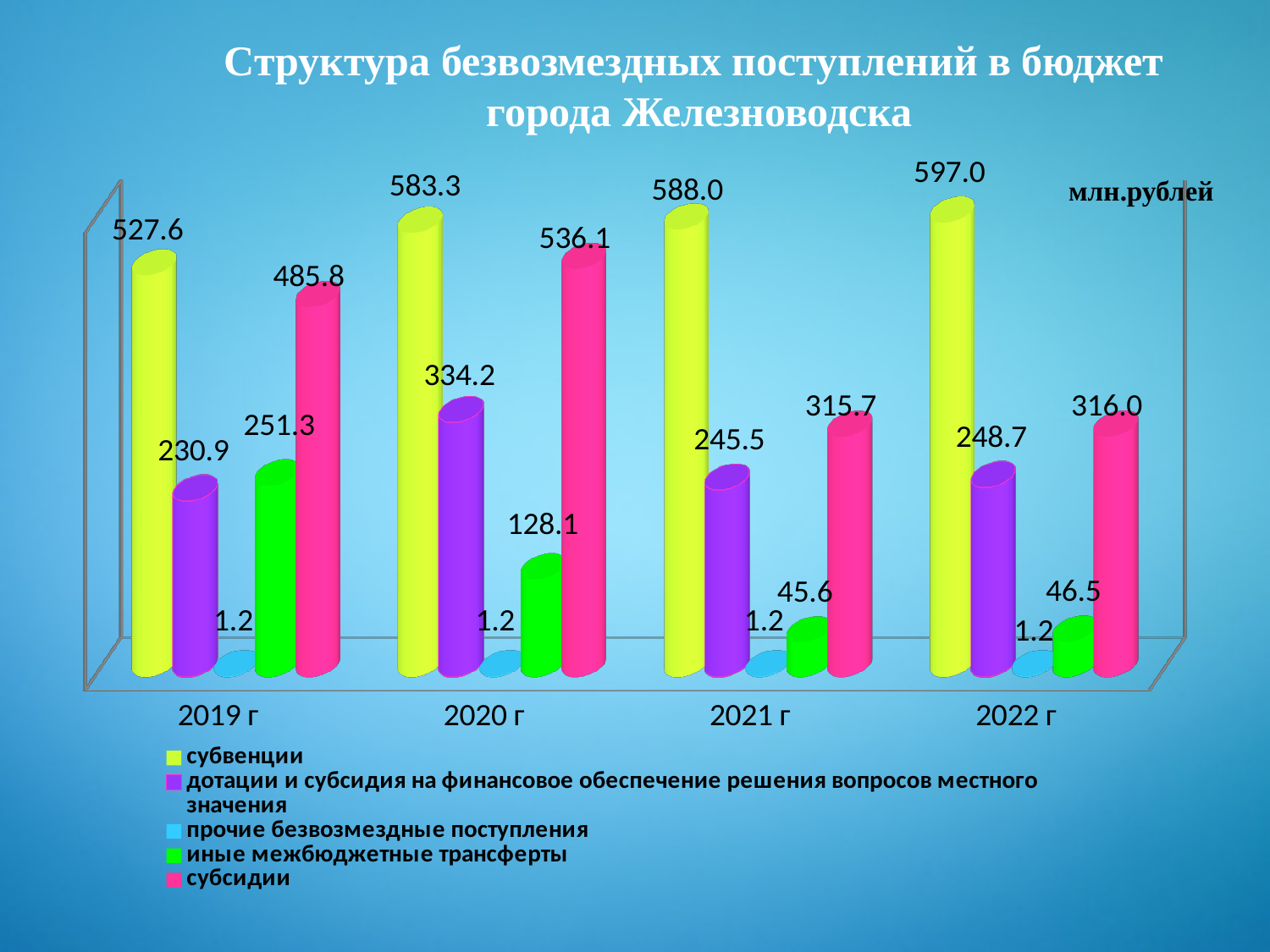
What is the value for субвенции in 2022 г? 597.0 What is the value for дотации и субсидия на финансовое обеспечение решения вопросов местного значения in 2019 г? 230.9 What is the value for субсидии in 2020 г? 536.1 How many years are shown on the x axis? 4 How many series does the legend list? 5 What is the value for иные межбюджетные трансферты in 2021 г? 45.6 What is the difference between субвенции and субсидии in 2021 г? 272.3 Do the values for субвенции rise or fall from 2019 г to 2022 г? rise In which year is the value for иные межбюджетные трансферты the lowest? 2021 г In which year is the value for субвенции the highest? 2022 г Which is larger in 2019 г: иные межбюджетные трансферты or дотации и субсидия на финансовое обеспечение решения вопросов местного значения? иные межбюджетные трансферты What kind of chart is shown on the slide? bar chart